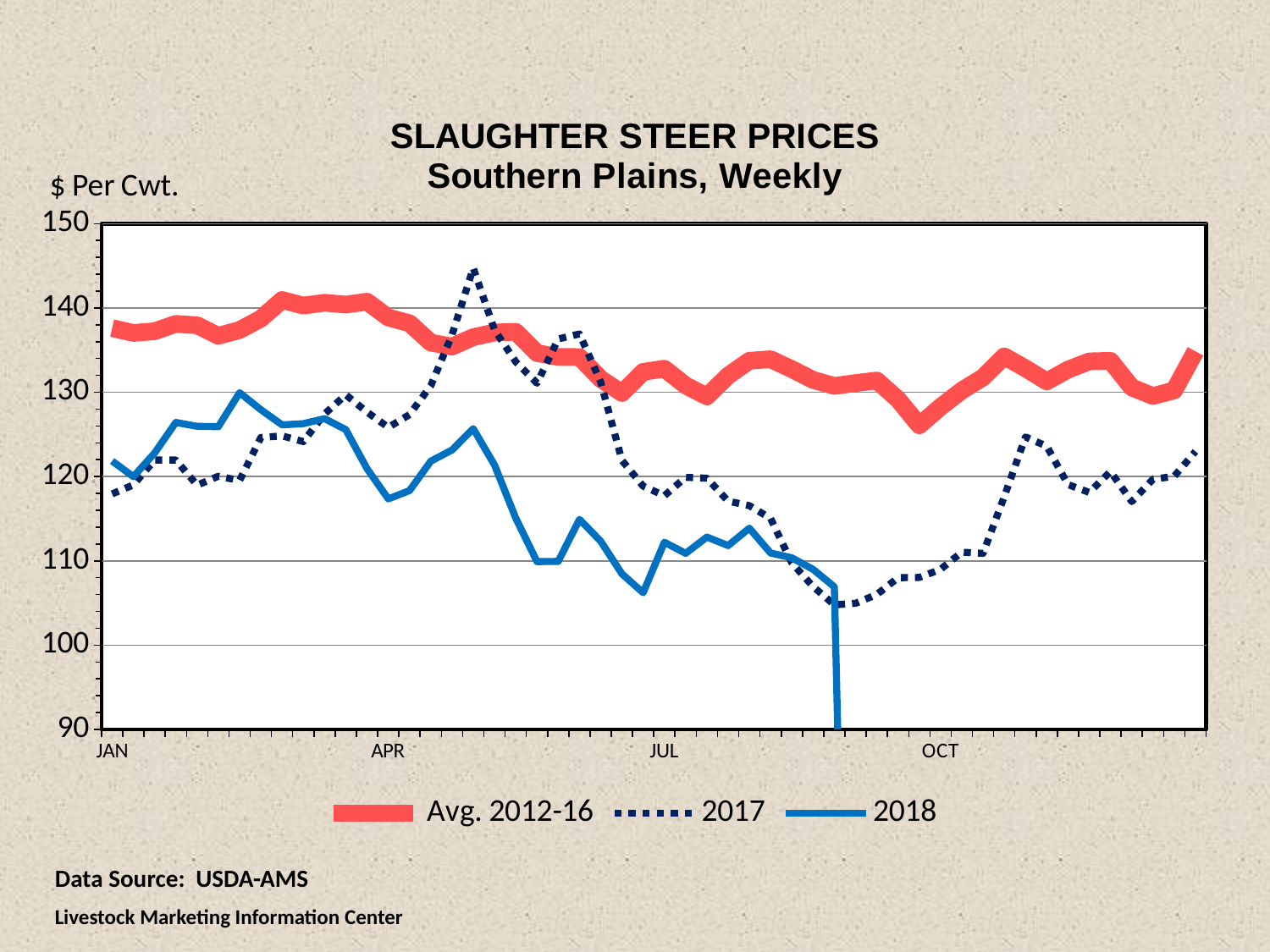
Is the value for 2017 at JAN greater or less than 120? less What kind of chart is shown on the slide? line chart Is the value for 2018 at JUL greater or less than 110? greater What unit is shown on the y axis label? $ Per Cwt. Is the value for Avg. 2012-16 at OCT greater or less than 130? less Does the 2018 line rise or fall from APR to JUL? fall At JAN, which is higher: Avg. 2012-16 or 2018? Avg. 2012-16 What is the title of the chart? SLAUGHTER STEER PRICES Southern Plains, Weekly How many series does the legend list? 3 At JUL, which is higher: 2017 or 2018? 2017